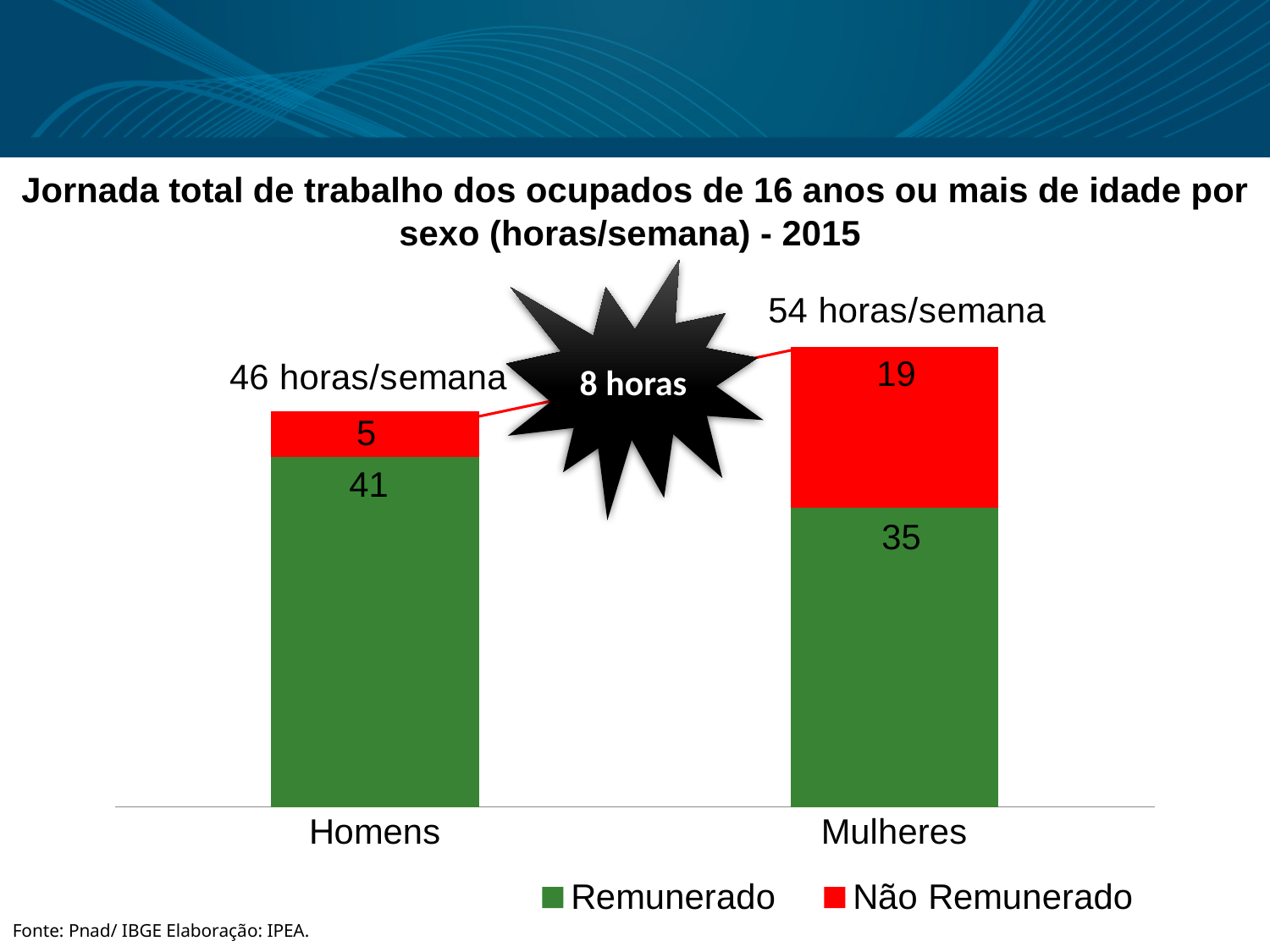
What is the Não Remunerado value for Mulheres? 19 What is the Remunerado value for Homens? 41 What is the Remunerado value for Mulheres? 35 Which category has the higher total work hours? Mulheres What is the total of the stacked bar for Mulheres? 54 How many categories are shown on the x axis? 2 How many series does the legend list? 2 What is the difference between the Não Remunerado values for Mulheres and Homens? 14 What is the total of the stacked bar for Homens? 46 Which category has the higher Remunerado value, Homens or Mulheres? Homens What is the Não Remunerado value for Homens? 5 What kind of chart is shown on the slide? Stacked bar chart